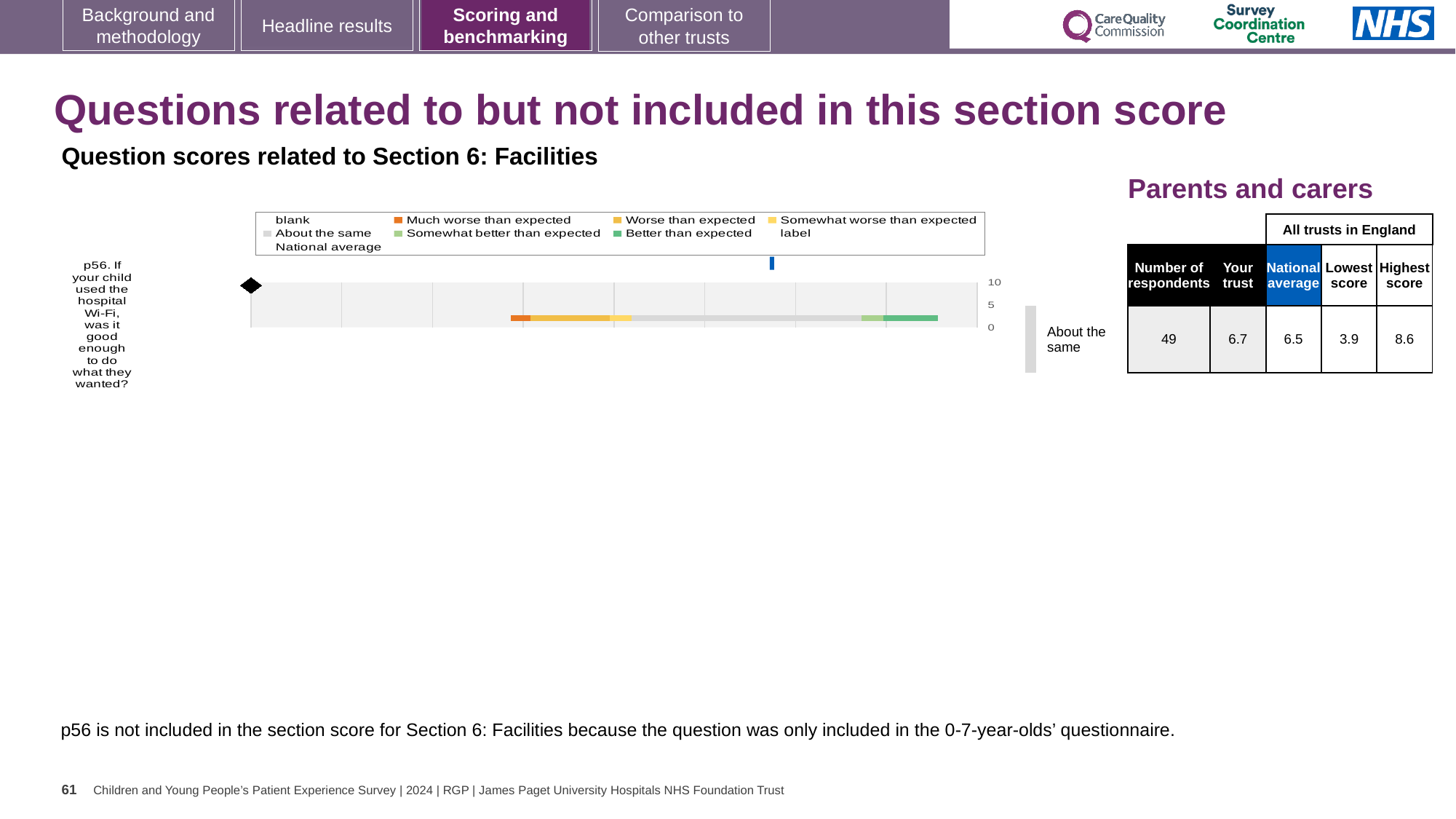
How many respondents answered question p56? 49 According to the table next to the chart, what is the national average score for p56? 6.5 What kind of chart is used to show the benchmarking for question p56? Bar chart What is the difference between the highest and lowest trust scores for p56? 4.7 According to the table next to the chart, what is the highest score among all trusts in England for p56? 8.6 Which benchmarking category does the trust's score for p56 fall into? About the same Which is larger for p56, the trust's score or the national average? The trust's score (6.7) Which question is plotted in the chart? p56. If your child used the hospital Wi-Fi, was it good enough to do what they wanted? How many survey questions are plotted in the chart? 1 According to the table next to the chart, what is the 'Your trust' score for p56? 6.7 What is the highest value shown on the chart's score axis? 10 According to the table next to the chart, what is the lowest score among all trusts in England for p56? 3.9